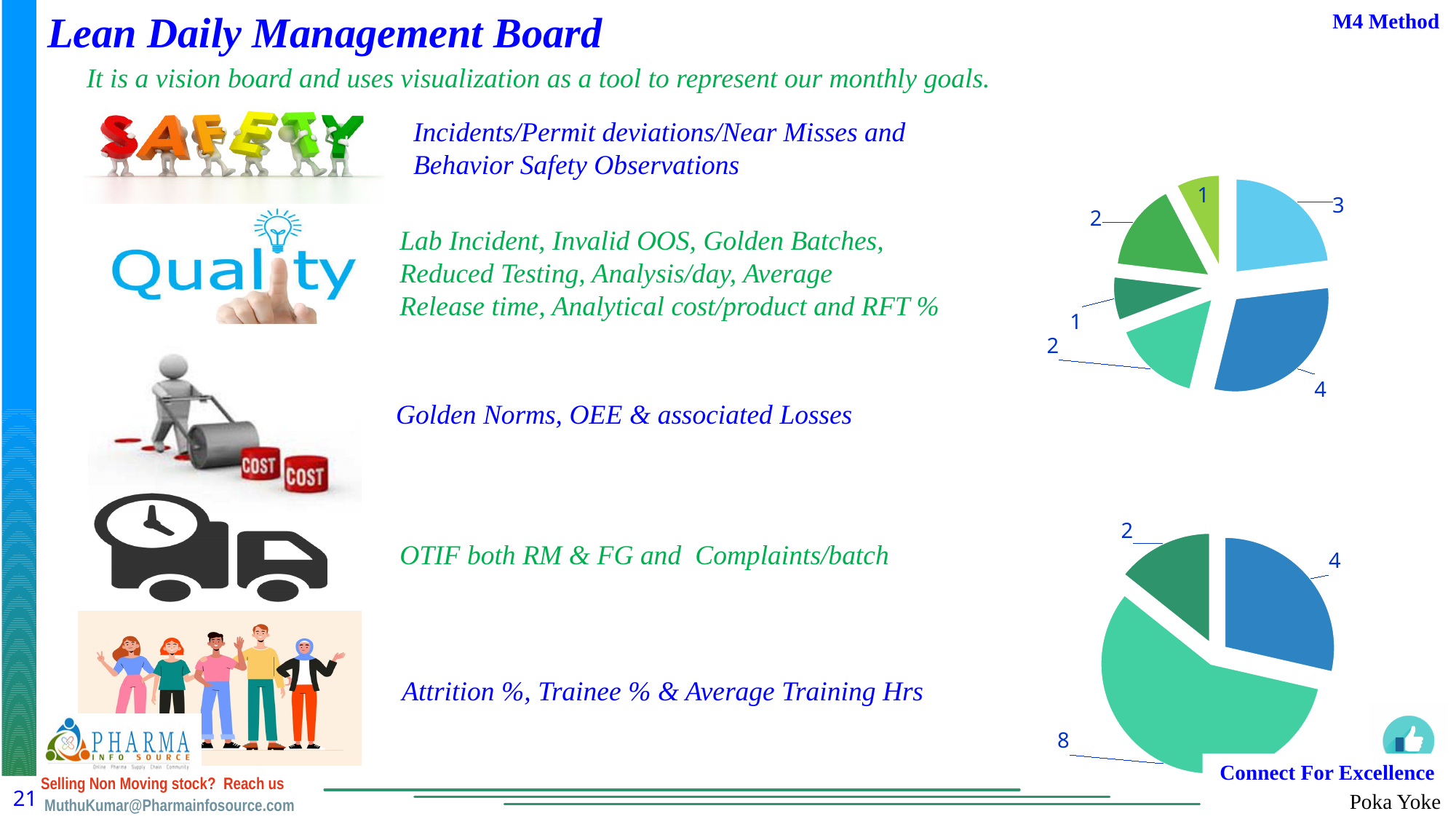
In the lower pie chart, what is the difference between the largest slice and the smallest slice? 6 In the lower pie chart, what is the value of the smallest slice? 2 What is the total of all slice values in the lower pie chart? 14 In the lower pie chart, what is the value of the largest slice? 8 What kind of chart is the lower chart on the right side of the slide? pie chart In the upper pie chart, what is the value of the largest slice? 4 In the upper pie chart, what is the value of the smallest slice? 1 In the lower pie chart, which slice is larger: the dark blue slice or the dark green slice? dark blue slice What kind of chart is the upper chart on the right side of the slide? pie chart What is the total of all slice values in the upper pie chart? 13 How many slices does the upper pie chart have? 6 How many slices does the lower pie chart have? 3